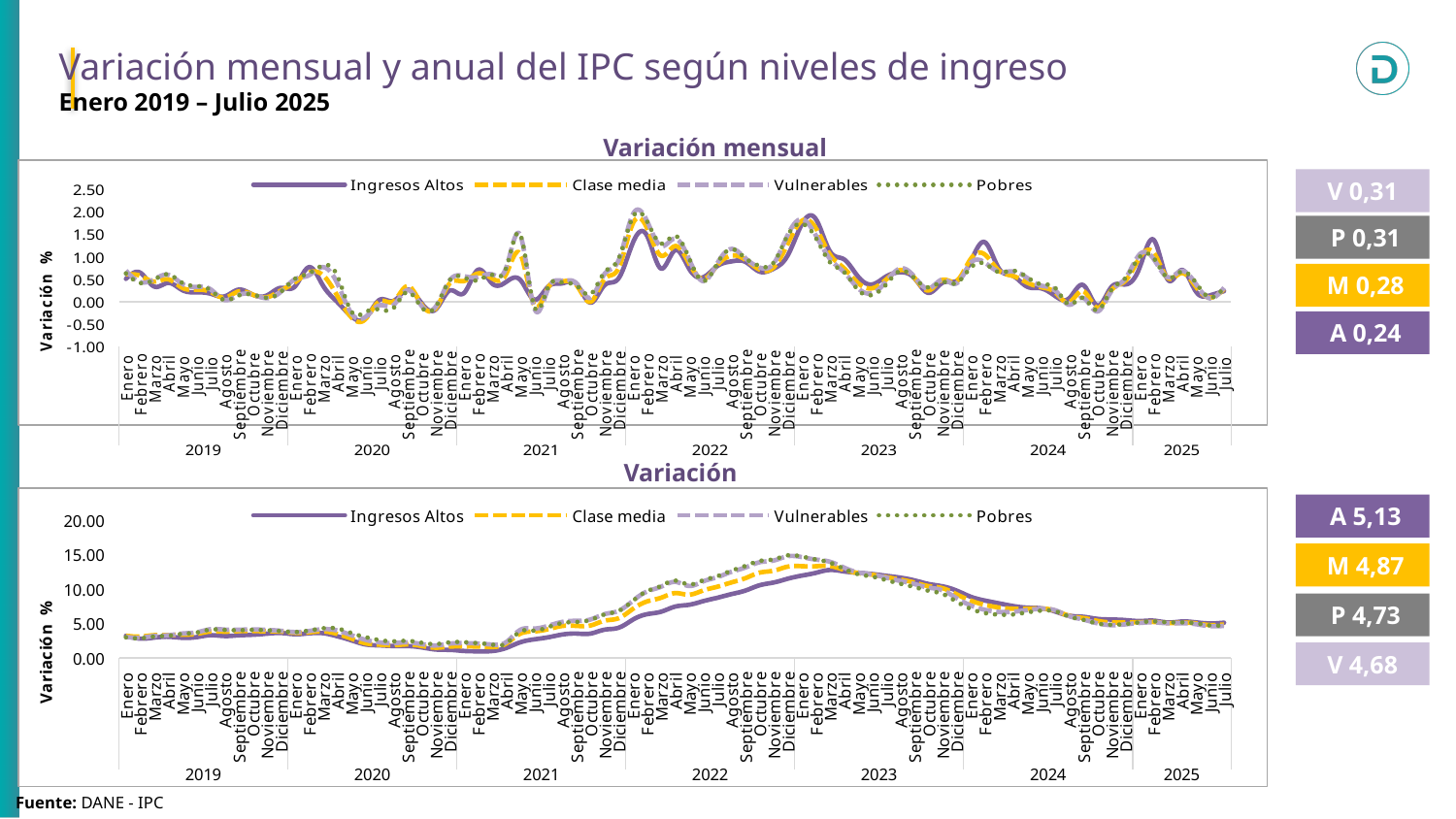
In the bottom 'Variación' chart, do the values rise or fall from early 2023 to mid 2025? fall In the bottom 'Variación' chart, which series is higher in late 2022: Pobres or Ingresos Altos? Pobres In the top 'Variación mensual' chart, is the peak value for Ingresos Altos in early 2022 greater or less than 1.00? greater In the bottom 'Variación' chart, are the values for all series during 2019 greater or less than 5.00? less According to the box beside the bottom 'Variación' chart, what is the value labelled A? 5,13 What is the highest tick shown on the y axis of the bottom 'Variación' chart? 20.00 What kind of chart is the 'Variación mensual' chart at the top of the slide? line chart How many series does the legend of the 'Variación mensual' chart list? 4 According to the boxes beside the top 'Variación mensual' chart, what is the value labelled M? 0,28 Which series are listed in the legend of the bottom 'Variación' chart? Ingresos Altos, Clase media, Vulnerables, Pobres In the bottom 'Variación' chart, is the value for Ingresos Altos around Marzo 2023 greater or less than 10.00? greater How many years are labelled along the x axis of the 'Variación mensual' chart? 7